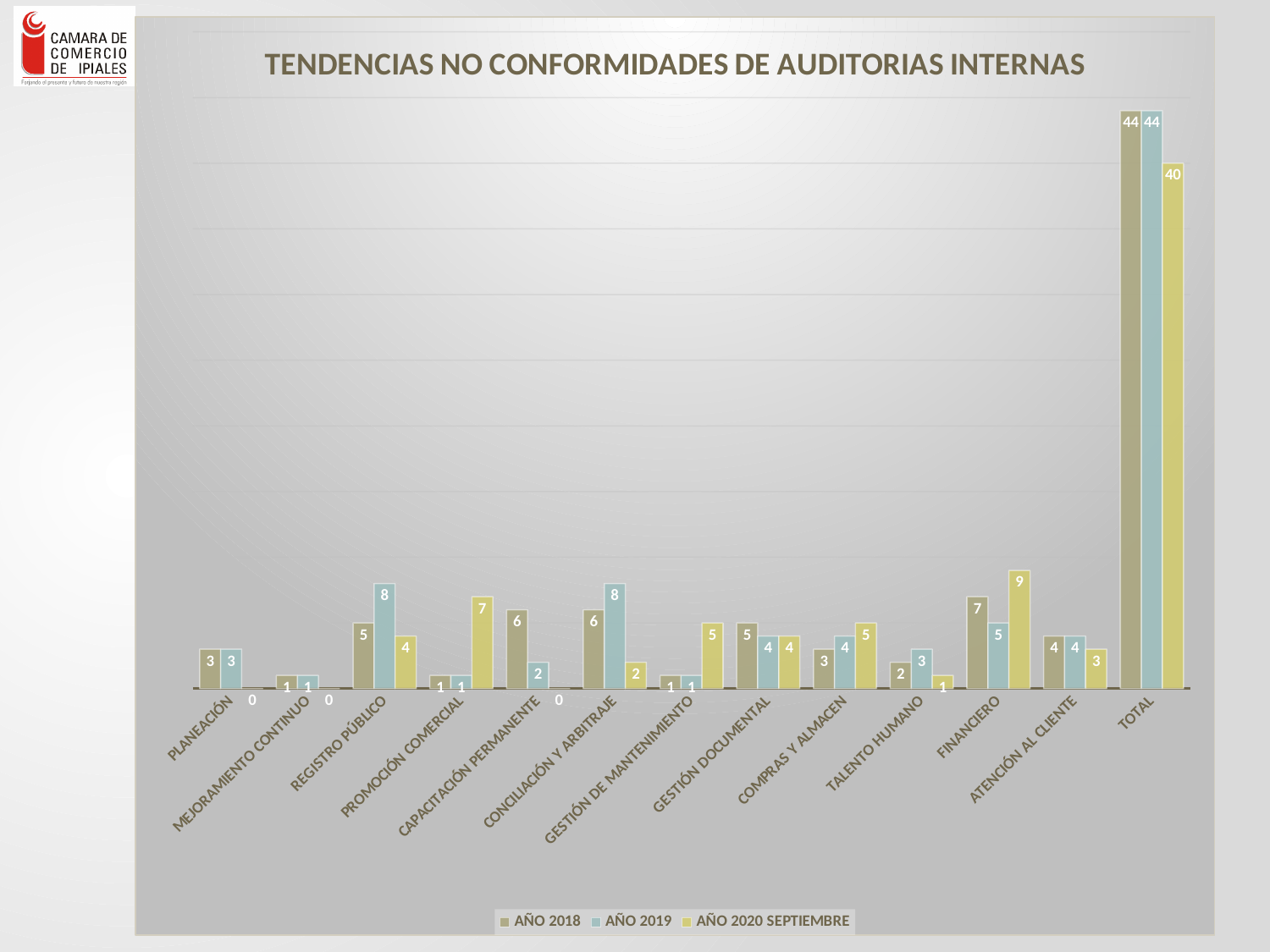
What is the TOTAL value for the AÑO 2020 SEPTIEMBRE series? 40 What kind of chart is shown on the slide? Bar chart What is the difference between the AÑO 2020 SEPTIEMBRE and AÑO 2018 values for PROMOCIÓN COMERCIAL? 6 How many series does the legend list? 3 What is the difference between the AÑO 2019 and AÑO 2020 SEPTIEMBRE values for TOTAL? 4 What is the title of the chart? TENDENCIAS NO CONFORMIDADES DE AUDITORIAS INTERNAS What is the value for CAPACITACIÓN PERMANENTE in the AÑO 2018 series? 6 How many categories are shown on the x axis? 13 Excluding TOTAL, which category has the highest value in the AÑO 2018 series? FINANCIERO Which is larger for CONCILIACIÓN Y ARBITRAJE: the AÑO 2018 value or the AÑO 2019 value? AÑO 2019 What is the value for REGISTRO PÚBLICO in the AÑO 2019 series? 8 What is the value for FINANCIERO in the AÑO 2020 SEPTIEMBRE series? 9